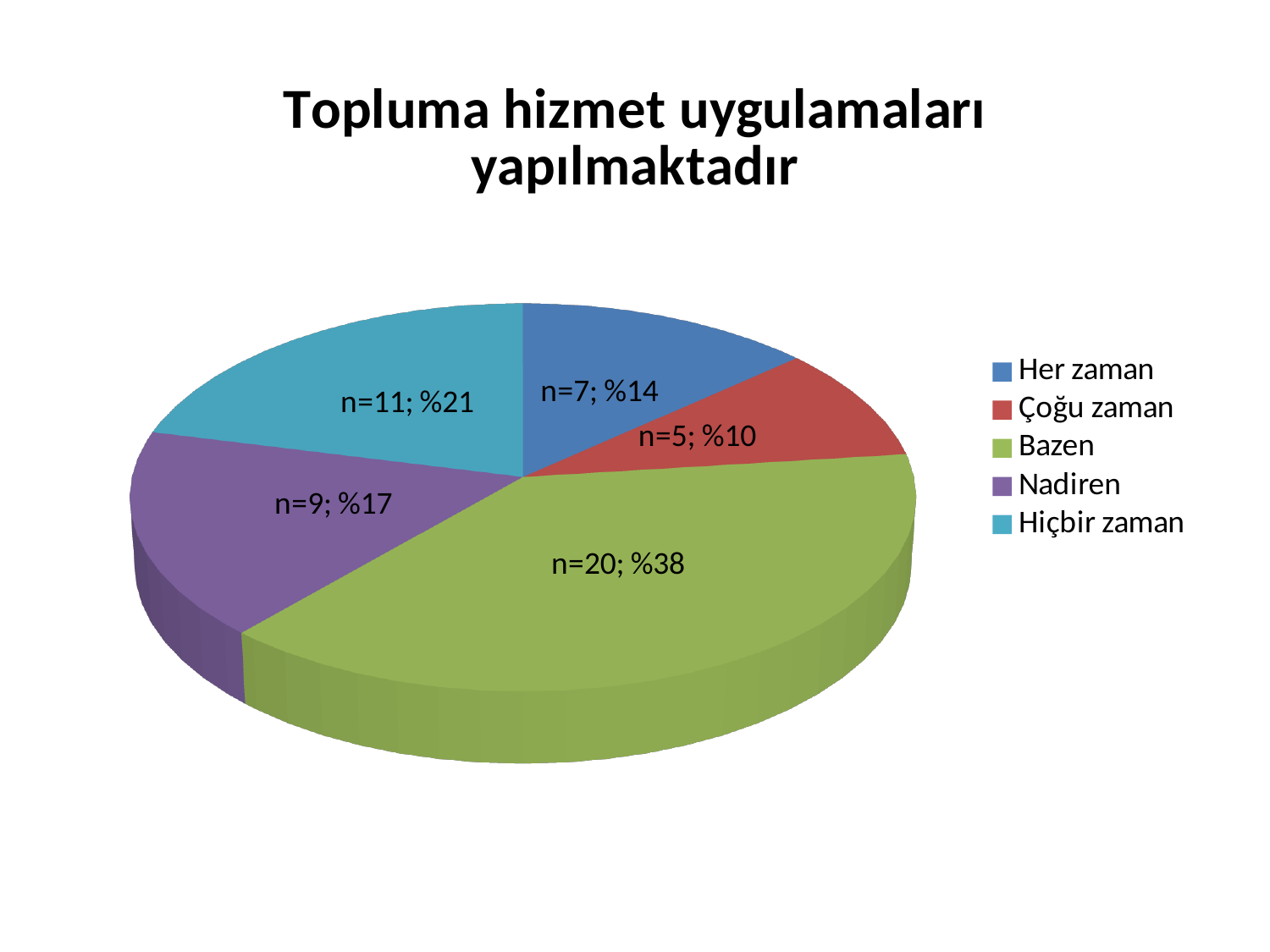
Which is larger, the Her zaman slice or the Hiçbir zaman slice? Hiçbir zaman What kind of chart is shown on the slide? pie chart What percentage share does the Hiçbir zaman slice have? %21 What is the difference in n between Bazen and Nadiren? 11 What is the title of the chart? Topluma hizmet uygulamaları yapılmaktadır Which category has the largest slice? Bazen Which colour represents Her zaman in the legend? blue What is the n value for the Çoğu zaman slice? n=5 What percentage share does the Nadiren slice have? %17 How many slices does the pie chart have? 5 Which category has the smallest slice? Çoğu zaman What is the n value for the Bazen slice? n=20